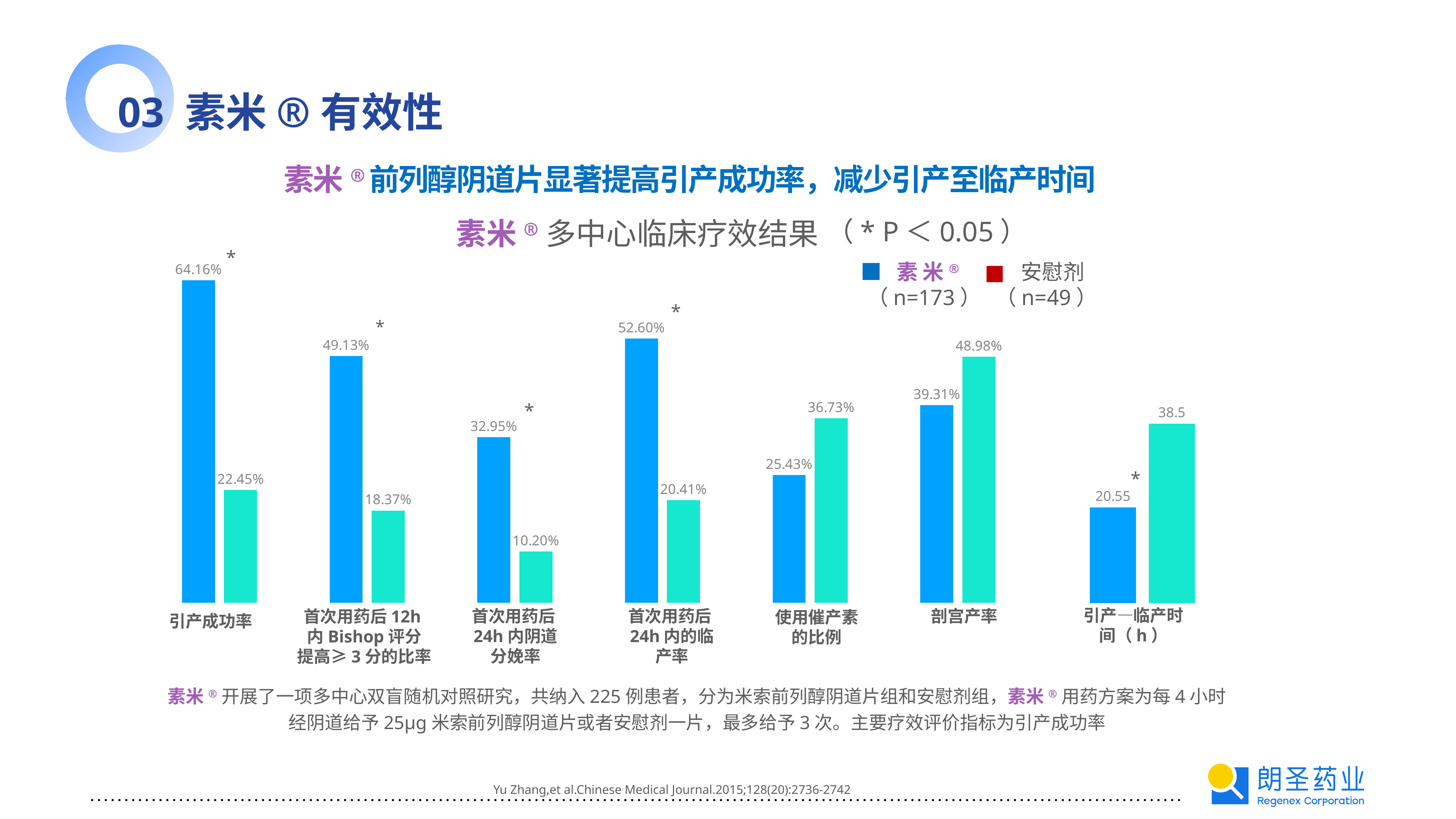
Which category has the lowest 安慰剂 value? 首次用药后24h内阴道分娩率 What kind of chart is shown on the slide? Bar chart What is the difference between the 素米® and 安慰剂 values for 引产成功率? 41.71% How many series does the legend list? 2 How many categories are shown on the x axis of the chart? 7 What is the 安慰剂 value for 引产成功率? 22.45% What is the 安慰剂 value for 剖宫产率? 48.98% What is the 安慰剂 value for 首次用药后24h内阴道分娩率? 10.20% What is the 素米® value for 引产成功率? 64.16% Which category has the highest 素米® value? 引产成功率 What is the 素米® value for 引产—临产时间（h）? 20.55 For 使用催产素的比例, which group has the larger value, 素米® or 安慰剂? 安慰剂